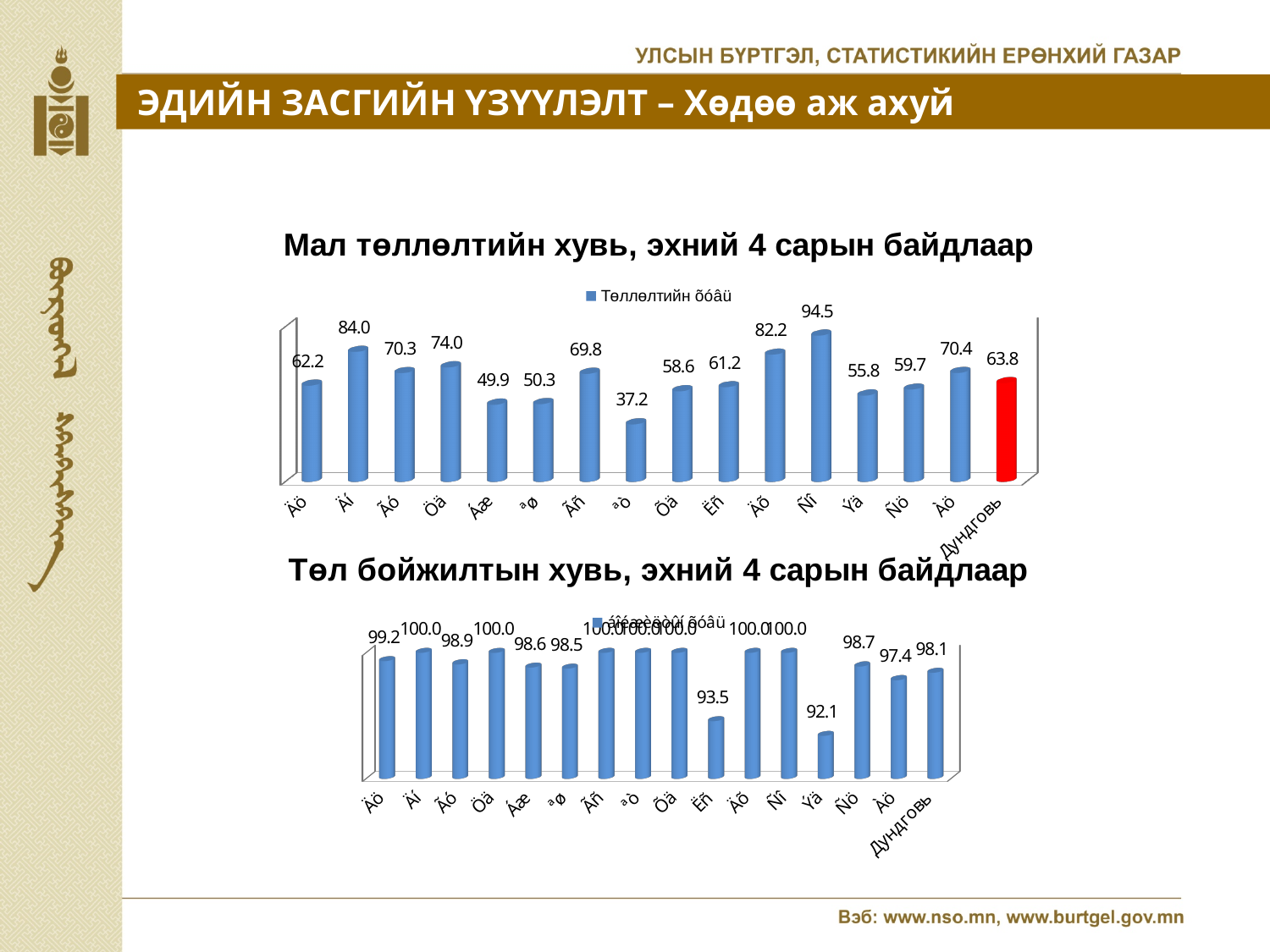
In the top chart (Мал төллөлтийн хувь), what is the highest value shown? 94.5 In the top chart (Мал төллөлтийн хувь), what colour is the bar for Дундговь? Red In the chart titled "Мал төллөлтийн хувь, эхний 4 сарын байдлаар", what is the value for Дундговь? 63.8 In the chart titled "Төл бойжилтын хувь, эхний 4 сарын байдлаар", what is the value for Дундговь? 98.1 In the top chart (Мал төллөлтийн хувь), what is the lowest value shown? 37.2 In the top chart (Мал төллөлтийн хувь), how many bars are plotted? 16 In the bottom chart (Төл бойжилтын хувь), what is the lowest value shown? 92.1 In the top chart (Мал төллөлтийн хувь), what is the difference between the highest value and the value for Дундговь? 30.7 Is the value for Дундговь in the top chart (Мал төллөлтийн хувь) larger or smaller than the value for Дундговь in the bottom chart (Төл бойжилтын хувь)? Smaller In the bottom chart (Төл бойжилтын хувь), how many bars are plotted? 16 What type of chart is the top chart (Мал төллөлтийн хувь)? Bar chart How many series does the legend of the top chart (Мал төллөлтийн хувь) list? 1